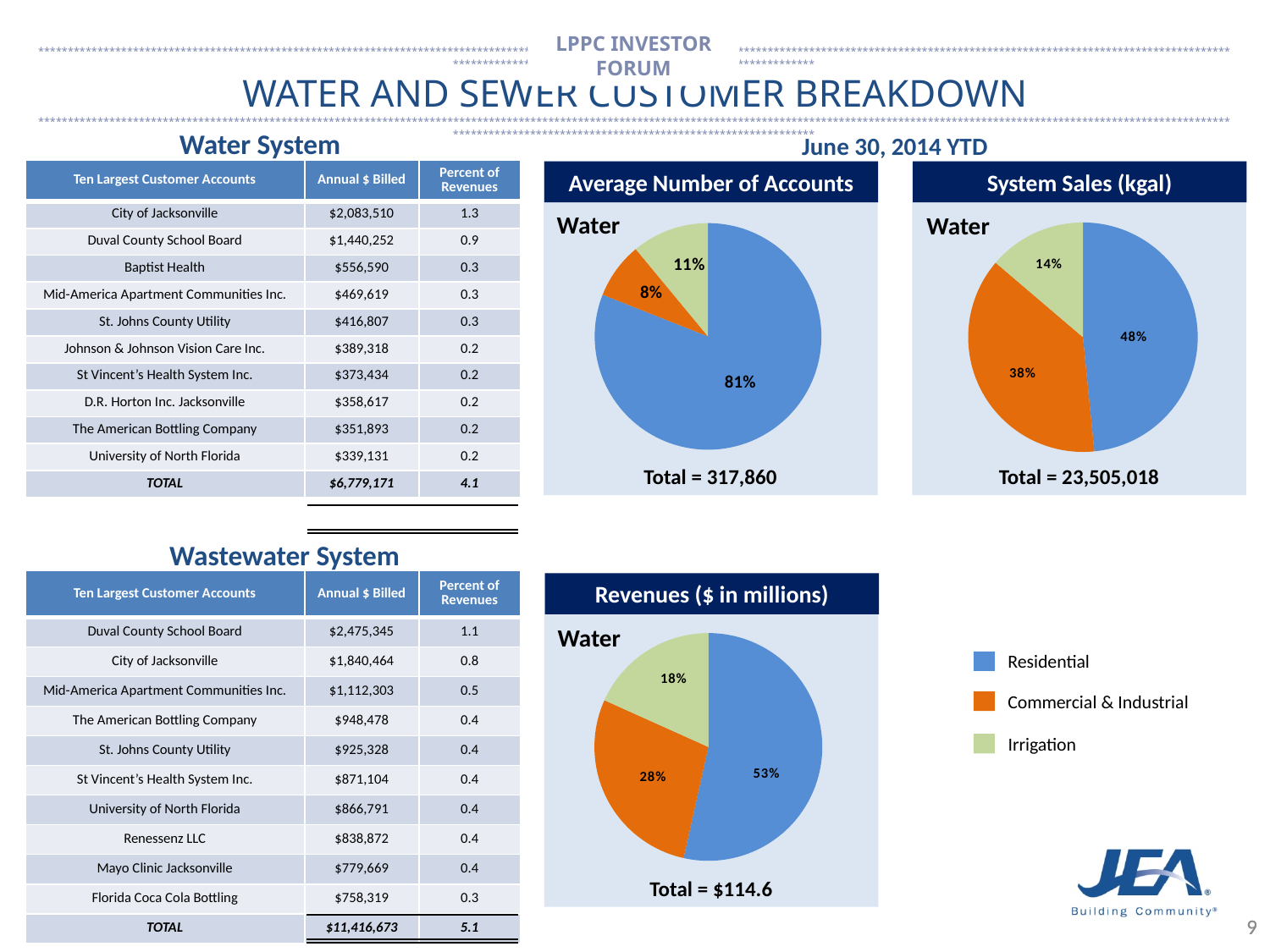
In the Revenues ($ in millions) chart, what is the total shown? $114.6 In the Average Number of Accounts chart, what is the total number of accounts shown? 317,860 In the Revenues ($ in millions) chart, what is the difference in percentage points between the Residential and Commercial & Industrial shares? 25 In the Revenues ($ in millions) chart, which category has the smallest share? Irrigation In the System Sales (kgal) chart, which category has the largest share? Residential In the System Sales (kgal) chart, what is the total shown? 23,505,018 In the System Sales (kgal) chart, what share is Commercial & Industrial? 38% What kind of chart is the Average Number of Accounts chart? Pie chart In the Revenues ($ in millions) chart, what share is Residential? 53% In the Average Number of Accounts chart, what share is Irrigation? 11% How many categories does the legend list for the pie charts? 3